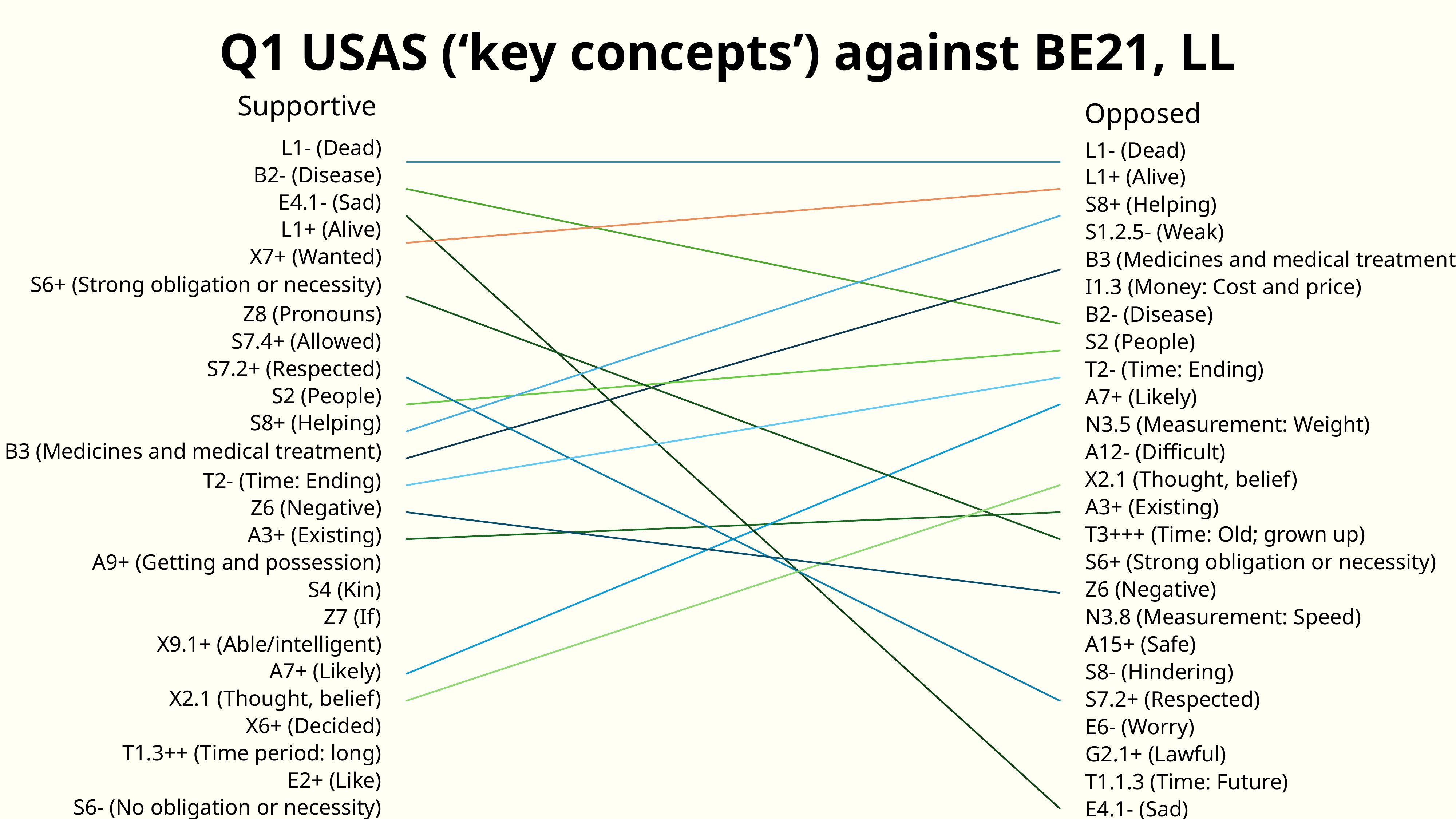
What are the two column headings of the chart? Supportive and Opposed Which key concept is ranked last in the Opposed column? E4.1- (Sad) What kind of chart is shown on the slide? slope chart Which key concept is ranked last in the Supportive column? S6- (No obligation or necessity) What is the title of the chart? Q1 USAS ('key concepts') against BE21, LL What rank does S8+ (Helping) hold in the Opposed column? 3 Which key concept is ranked first in both the Supportive and Opposed columns? L1- (Dead) How many key concepts are listed in the Supportive column? 25 Does the line for A7+ (Likely) rise or fall from the Supportive column to the Opposed column? rise What rank does E4.1- (Sad) hold in the Supportive column? 3 Which is ranked higher in the Opposed column, L1+ (Alive) or B2- (Disease)? L1+ (Alive) How many key concepts are listed in the Opposed column? 25